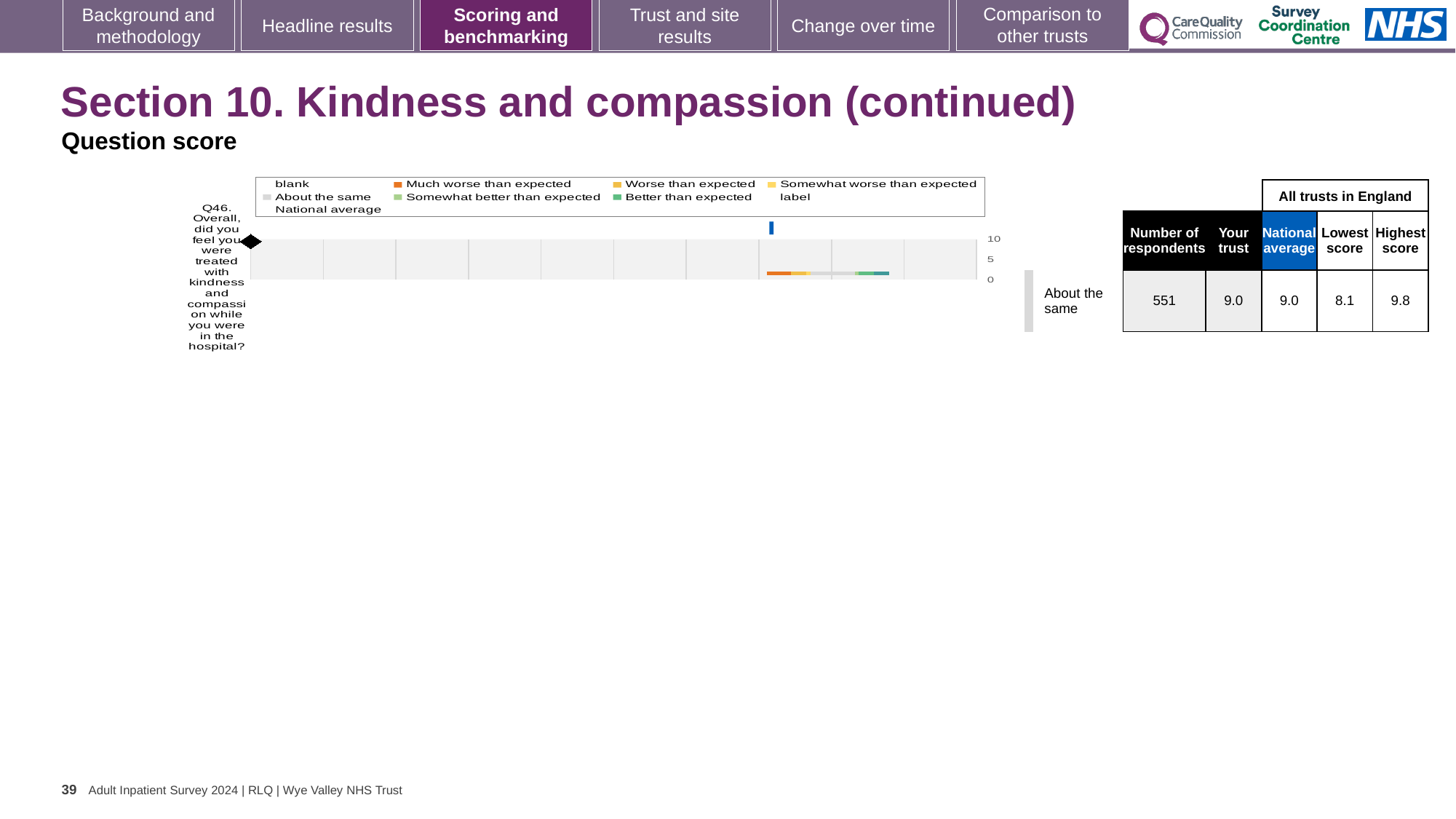
How many respondents answered Q46? 551 What is the Highest score among all trusts in England for Q46? 9.8 What is the National average score for Q46? 9.0 How many questions are plotted on the chart? 1 What is the Lowest score among all trusts in England for Q46? 8.1 Which is larger for Q46, the Highest score or Your trust score? Highest score Is the value for Your trust on Q46 greater or less than 5? greater What kind of chart is shown on the slide? bar chart What is the score for Your trust on Q46? 9.0 Which question is plotted on the chart? Q46. Overall, did you feel you were treated with kindness and compassion while you were in the hospital? How is the trust's result for Q46 categorised relative to expectations? About the same What is the difference between the Highest score and the Lowest score for Q46? 1.7